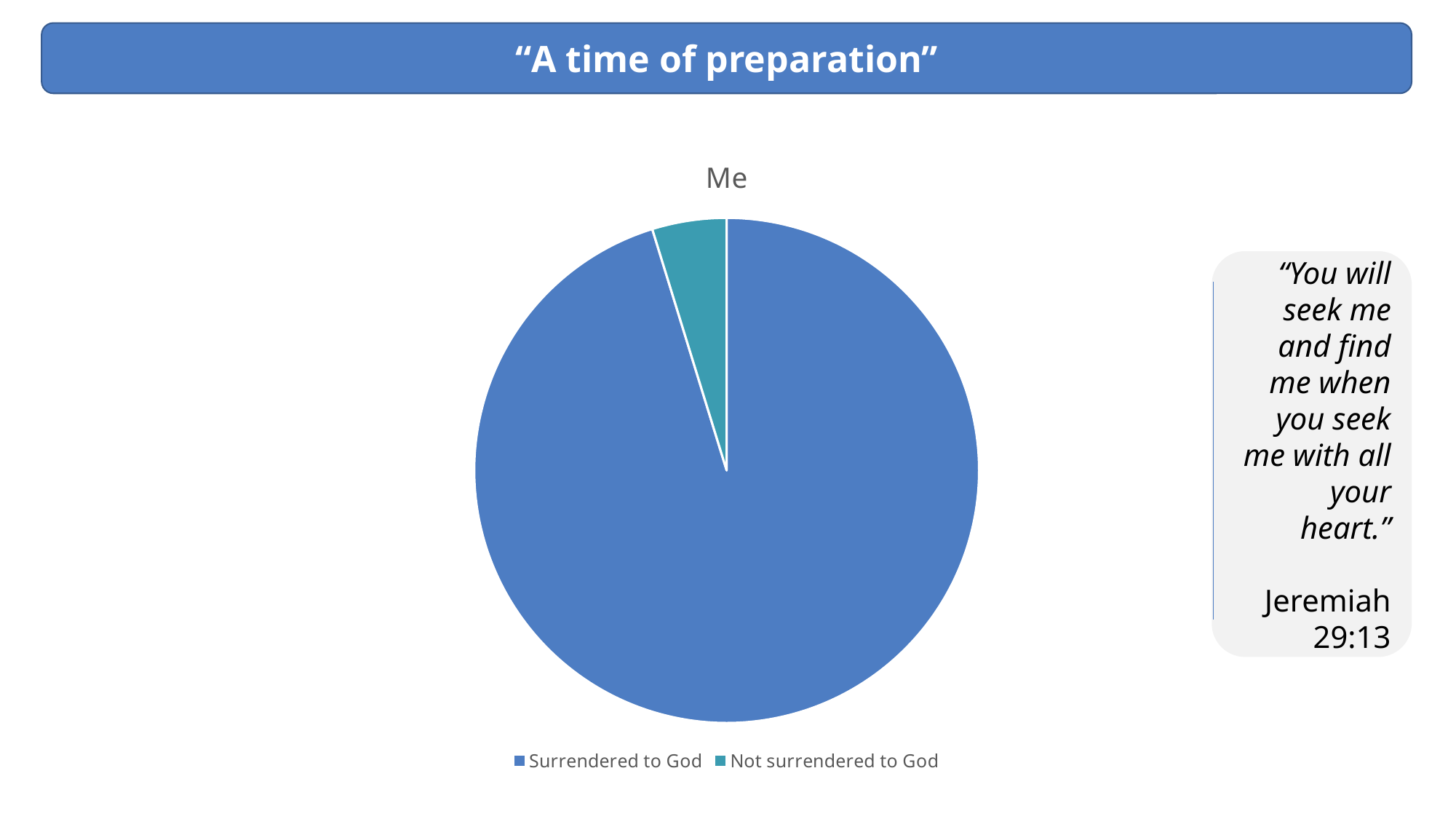
What kind of chart is shown on the slide? pie chart How many slices does the pie chart have? 2 Which slice of the pie chart is the largest? Surrendered to God What colour is the slice for Not surrendered to God? teal Which slice of the pie chart is the smallest? Not surrendered to God What is the title of the chart? Me How many entries does the legend list? 2 Which is larger, the slice for Surrendered to God or the slice for Not surrendered to God? Surrendered to God